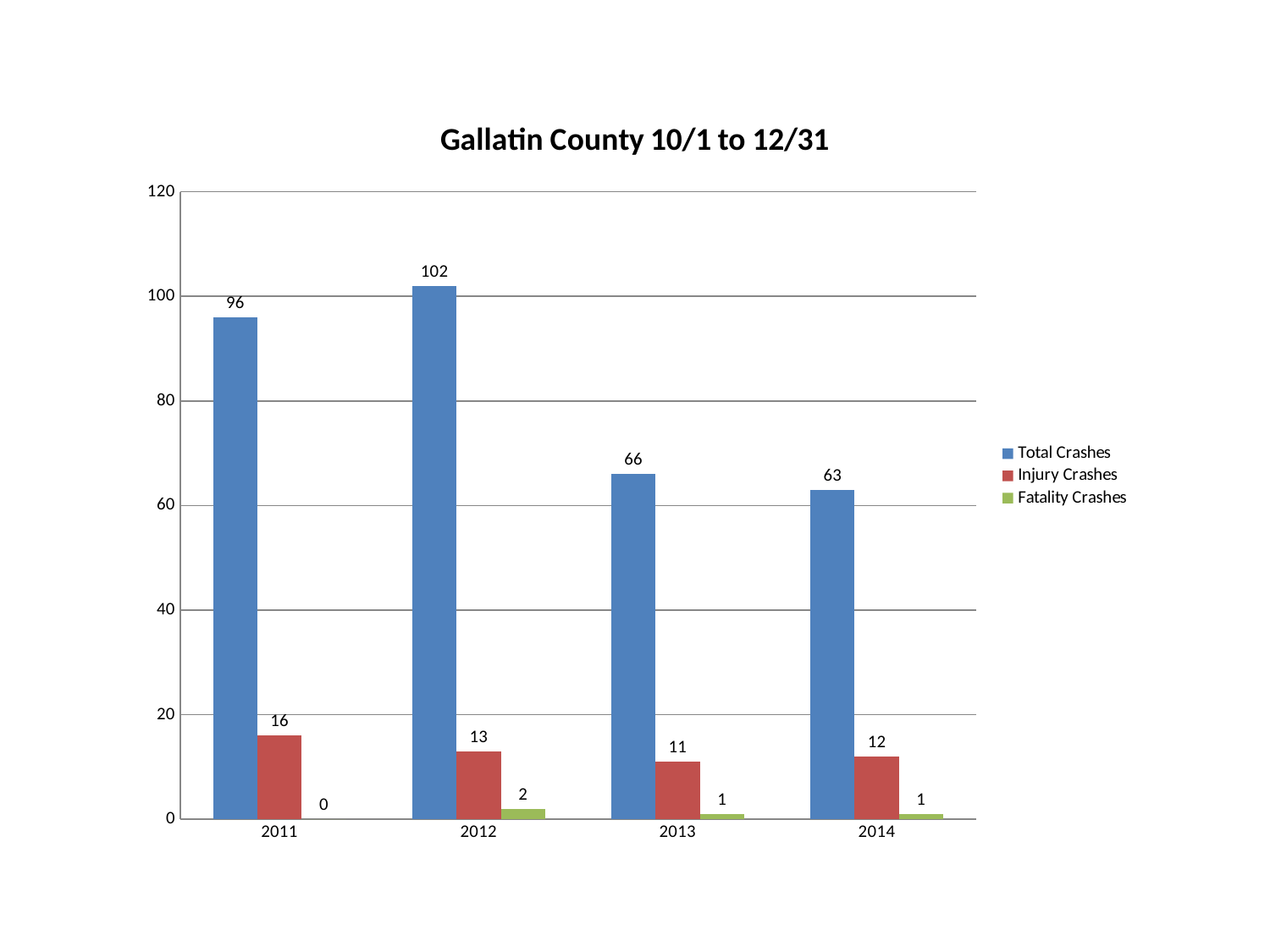
What is the difference between Total Crashes in 2011 and 2013? 30 What kind of chart is shown? bar chart How many series does the legend list? 3 Which is larger, Injury Crashes in 2012 or Injury Crashes in 2014? 2012 What is the title of the chart? Gallatin County 10/1 to 12/31 How many years are shown on the x axis? 4 Which year has the lowest Injury Crashes? 2013 What is the value of Injury Crashes for 2011? 16 Which year has the highest Total Crashes? 2012 Is the value of Total Crashes for 2014 greater or less than 80? less What is the value of Total Crashes for 2012? 102 What is the value of Fatality Crashes for 2012? 2